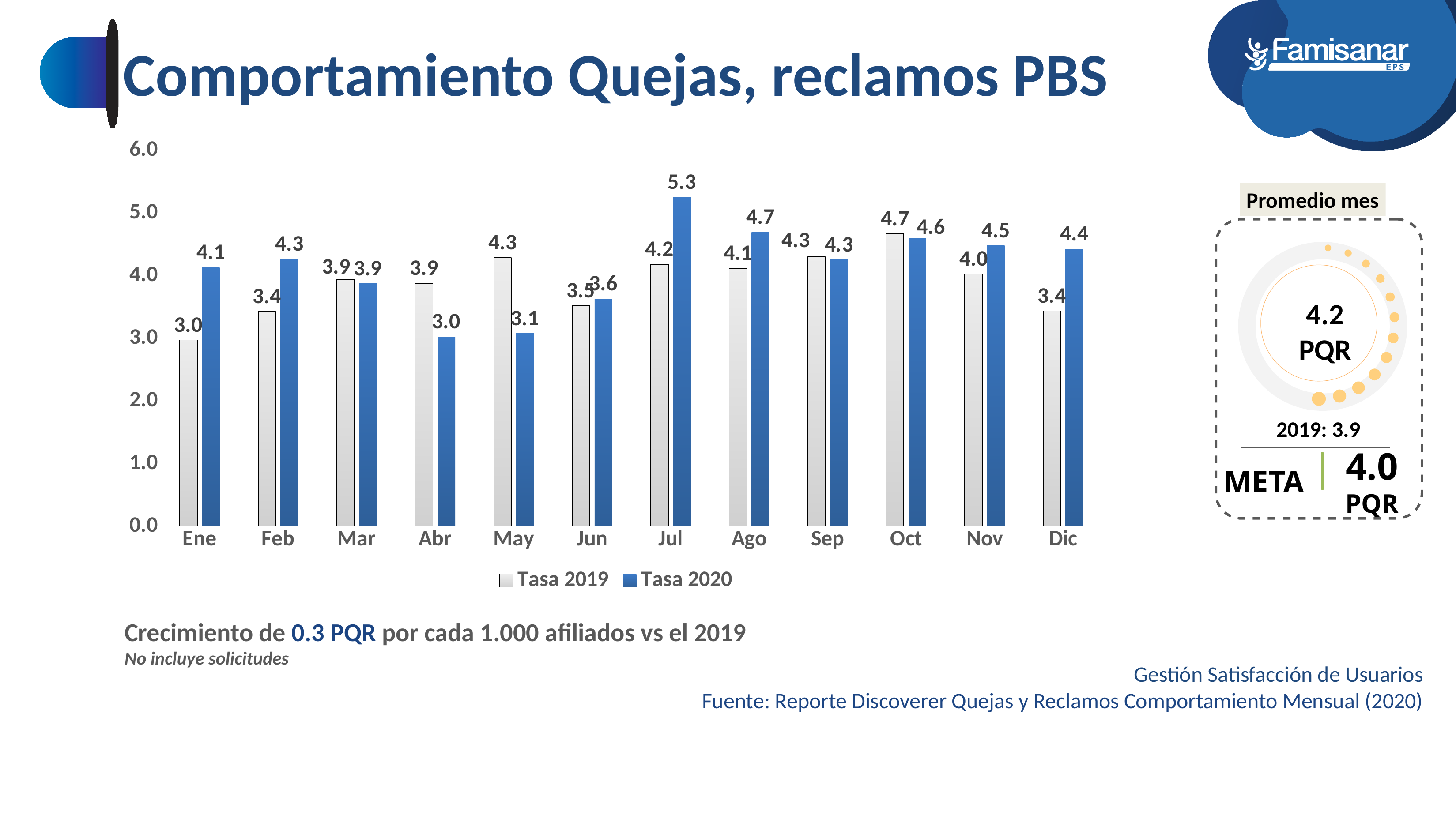
What is the Tasa 2019 value for Oct? 4.7 In May, which series has the larger value, Tasa 2019 or Tasa 2020? Tasa 2019 What is the difference between the Tasa 2019 and Tasa 2020 values for Abr? 0.9 Which month has the lowest Tasa 2019 value? Ene What is the Tasa 2020 value for Abr? 3.0 How many series does the chart legend list? 2 Which month has the highest Tasa 2020 value? Jul How many months are shown on the x axis of the chart? 12 In Ene, which series has the larger value, Tasa 2019 or Tasa 2020? Tasa 2020 What type of chart is shown on the slide? Bar chart What is the difference between the Tasa 2020 and Tasa 2019 values for Jul? 1.1 What is the Tasa 2020 value for Jul? 5.3